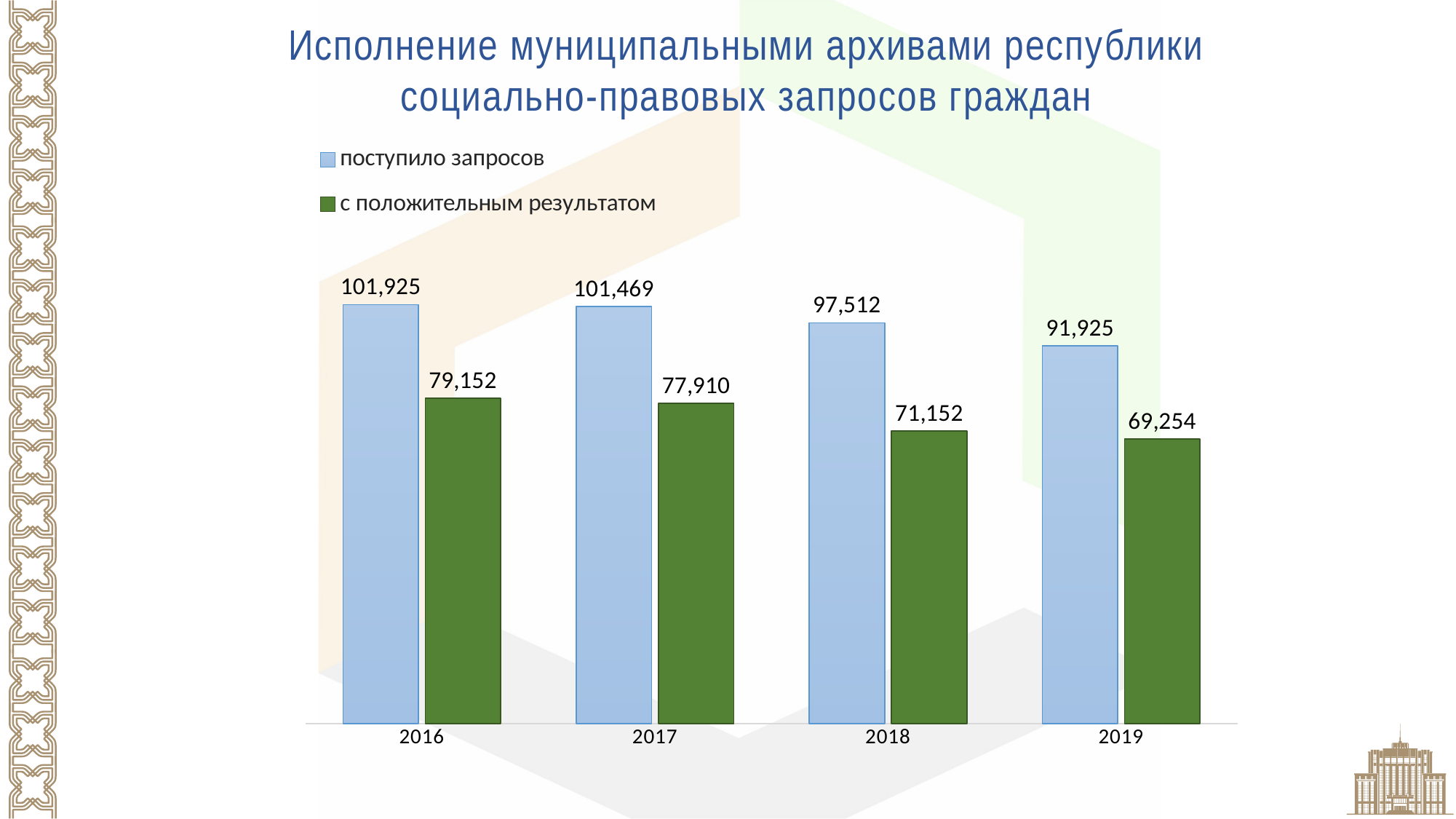
Which is larger: 'с положительным результатом' in 2016 or in 2018? 2016 What is the value for 'с положительным результатом' in 2019? 69,254 What is the difference between 'поступило запросов' and 'с положительным результатом' in 2018? 26,360 How many years are shown on the x axis? 4 Which year has the highest value for 'поступило запросов'? 2016 How many series does the legend list? 2 What is the value for 'с положительным результатом' in 2017? 77,910 Which year has the lowest value for 'с положительным результатом'? 2019 What is the value for 'поступило запросов' in 2016? 101,925 What kind of chart is shown on the slide? Bar chart What is the difference between 'поступило запросов' in 2016 and in 2019? 10,000 What is the value for 'поступило запросов' in 2018? 97,512